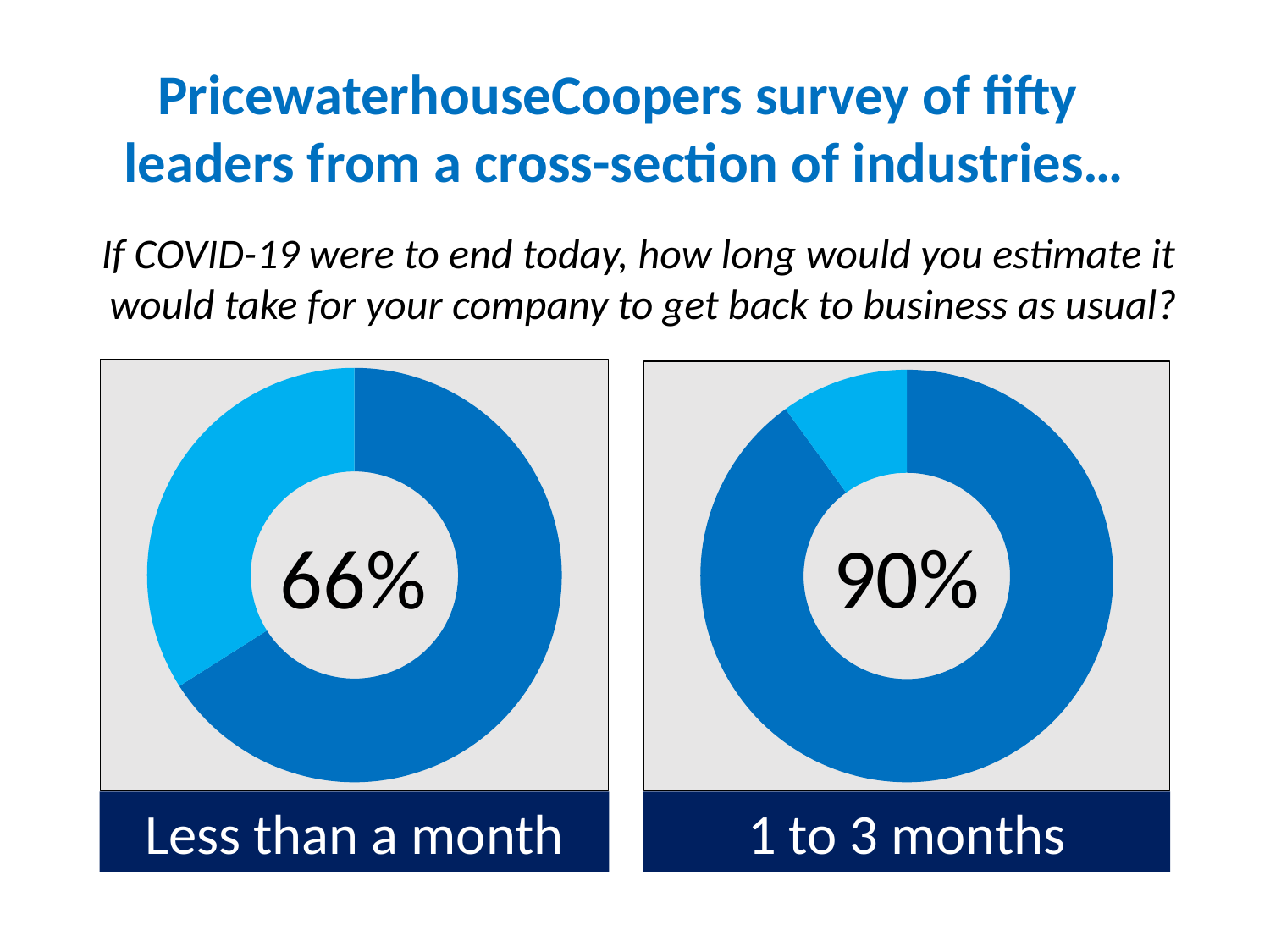
Which chart shows the larger percentage, 'Less than a month' or '1 to 3 months'? 1 to 3 months What is the difference between the percentage in the '1 to 3 months' chart and the percentage in the 'Less than a month' chart? 24% In the 'Less than a month' chart, what percentage is shown in the centre of the donut? 66% In the '1 to 3 months' chart, what percentage is shown in the centre of the donut? 90% What is the label beneath the left-hand donut chart? Less than a month In the 'Less than a month' chart, what share of the donut is the light blue remainder segment? 34% How many donut charts are shown on the slide? 2 What is the label beneath the right-hand donut chart? 1 to 3 months What kind of chart is used on the left of the slide, labelled 'Less than a month'? Donut chart In the 'Less than a month' chart, is the highlighted value greater or less than 50%? greater In the '1 to 3 months' chart, what share of the donut is not covered by the dark blue 90% segment? 10%